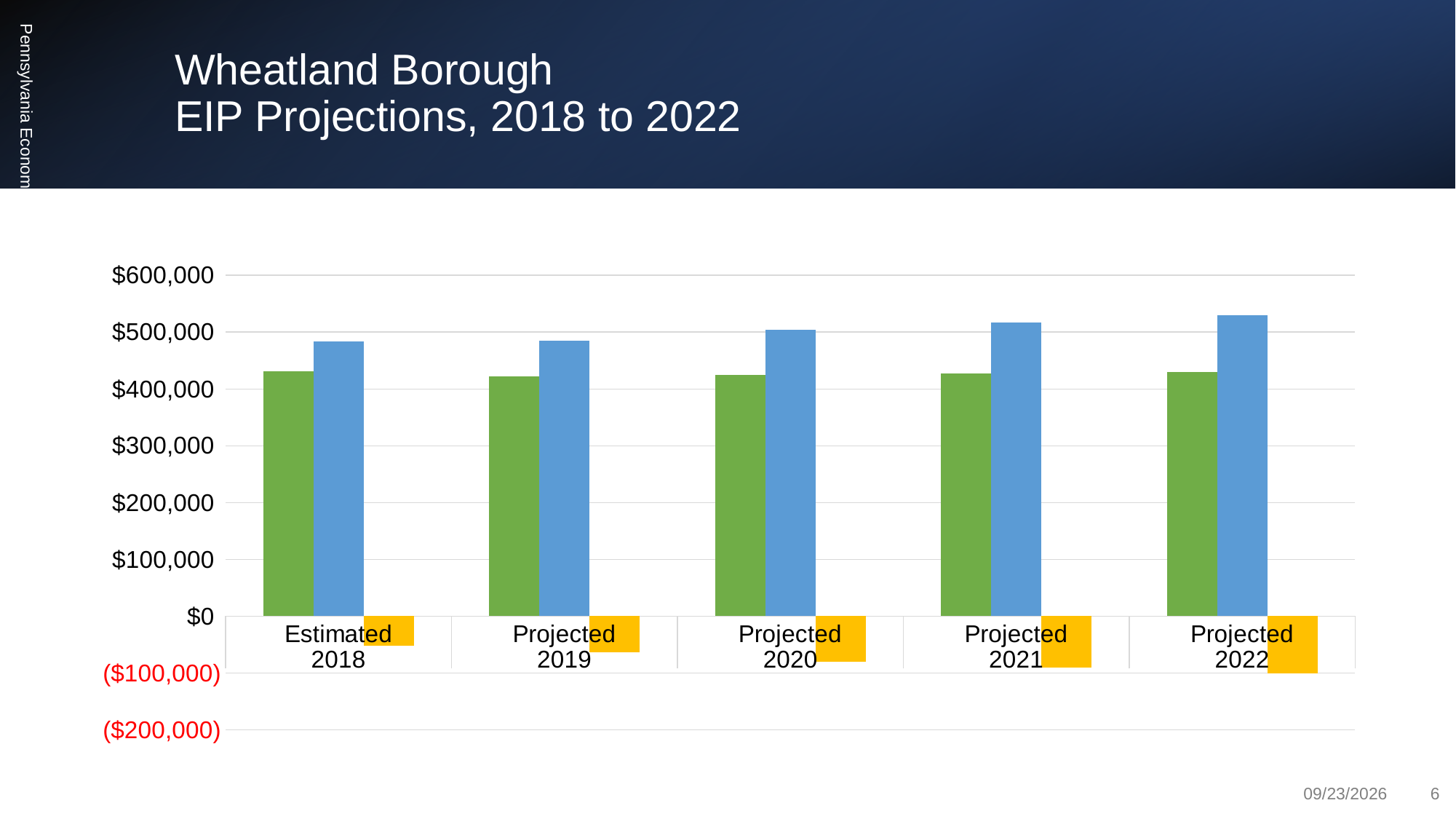
Which year has the tallest blue bar? Projected 2022 Which year has the orange bar that extends furthest below $0? Projected 2022 Is the blue bar for Projected 2022 greater or less than $500,000? greater Do the blue bars rise or fall from Estimated 2018 to Projected 2022? rise Is the blue bar for Estimated 2018 greater or less than $500,000? less Which year has the smallest (shortest) orange bar below $0? Estimated 2018 Is the orange bar for Projected 2021 greater or less than $0? less How many bars are plotted for each year category? 3 How many year categories are shown on the x axis? 5 For Projected 2020, which is larger, the green bar or the blue bar? the blue bar What kind of chart is shown on the slide? bar chart